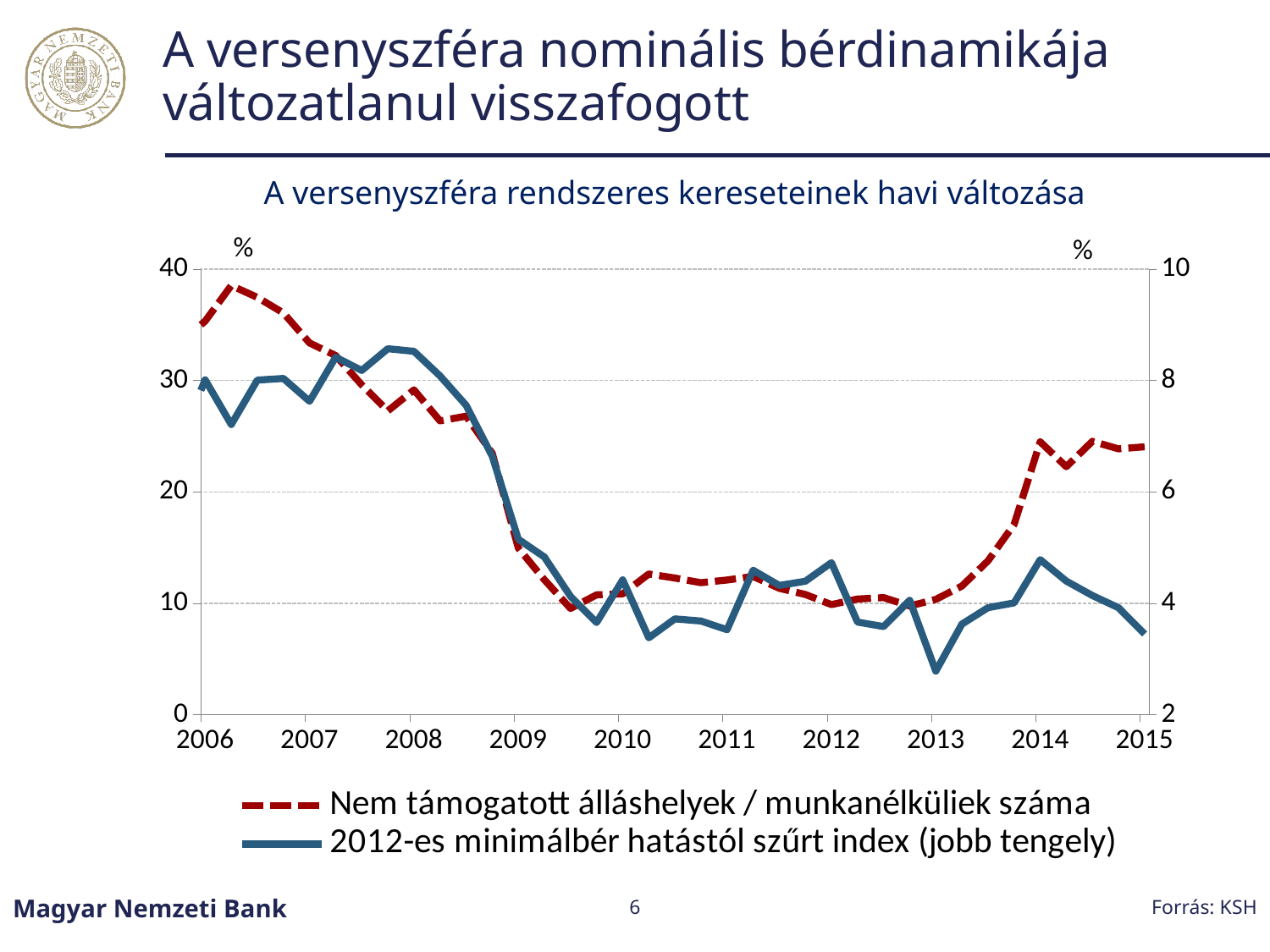
Is the value of the 'Nem támogatott álláshelyek / munkanélküliek száma' series at 2014 greater or less than 20? greater Does the '2012-es minimálbér hatástól szűrt index (jobb tengely)' series rise or fall between 2014 and 2015? fall How many year labels are shown on the x axis? 10 Is the value of the 'Nem támogatott álláshelyek / munkanélküliek száma' series at 2006 greater or less than 30? greater What kind of chart is shown on the slide? line chart Which series is plotted on the right axis according to the legend? 2012-es minimálbér hatástól szűrt index (jobb tengely) Is the value of the '2012-es minimálbér hatástól szűrt index (jobb tengely)' series at 2013 greater or less than 4 on the right axis? less What is the title of the chart? A versenyszféra rendszeres kereseteinek havi változása Does the 'Nem támogatott álláshelyek / munkanélküliek száma' series rise or fall between 2013 and 2014? rise How many series does the legend list? 2 Does the 'Nem támogatott álláshelyek / munkanélküliek száma' series rise or fall between 2006 and 2009? fall